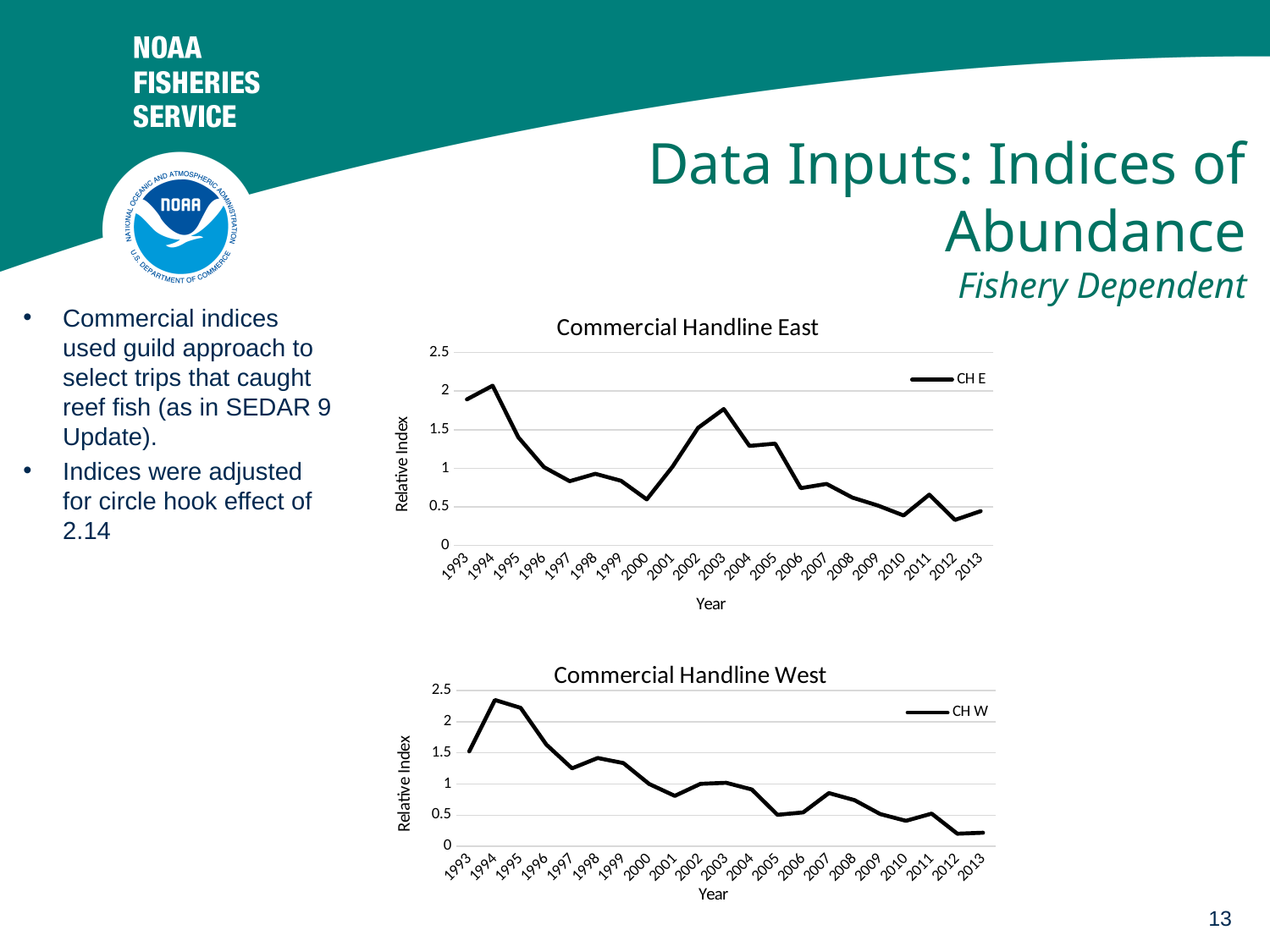
In the Commercial Handline East chart, is the value for 2003 greater or less than 1.5? greater In the Commercial Handline West chart, is the value for 1995 greater or less than 2? greater In the Commercial Handline West chart, is the relative index higher in 1994 or in 2013? 1994 In the Commercial Handline West chart, is the value for 2012 greater or less than 0.5? less What is the legend entry on the Commercial Handline East chart? CH E What kind of chart is the Commercial Handline East chart? line chart In the Commercial Handline East chart, which year has the highest relative index? 1994 How many series does the legend of the Commercial Handline West chart list? 1 In the Commercial Handline West chart, which year has the highest relative index? 1994 In the Commercial Handline East chart, which year has the lowest relative index? 2012 How many years are plotted on the x axis of the Commercial Handline West chart? 21